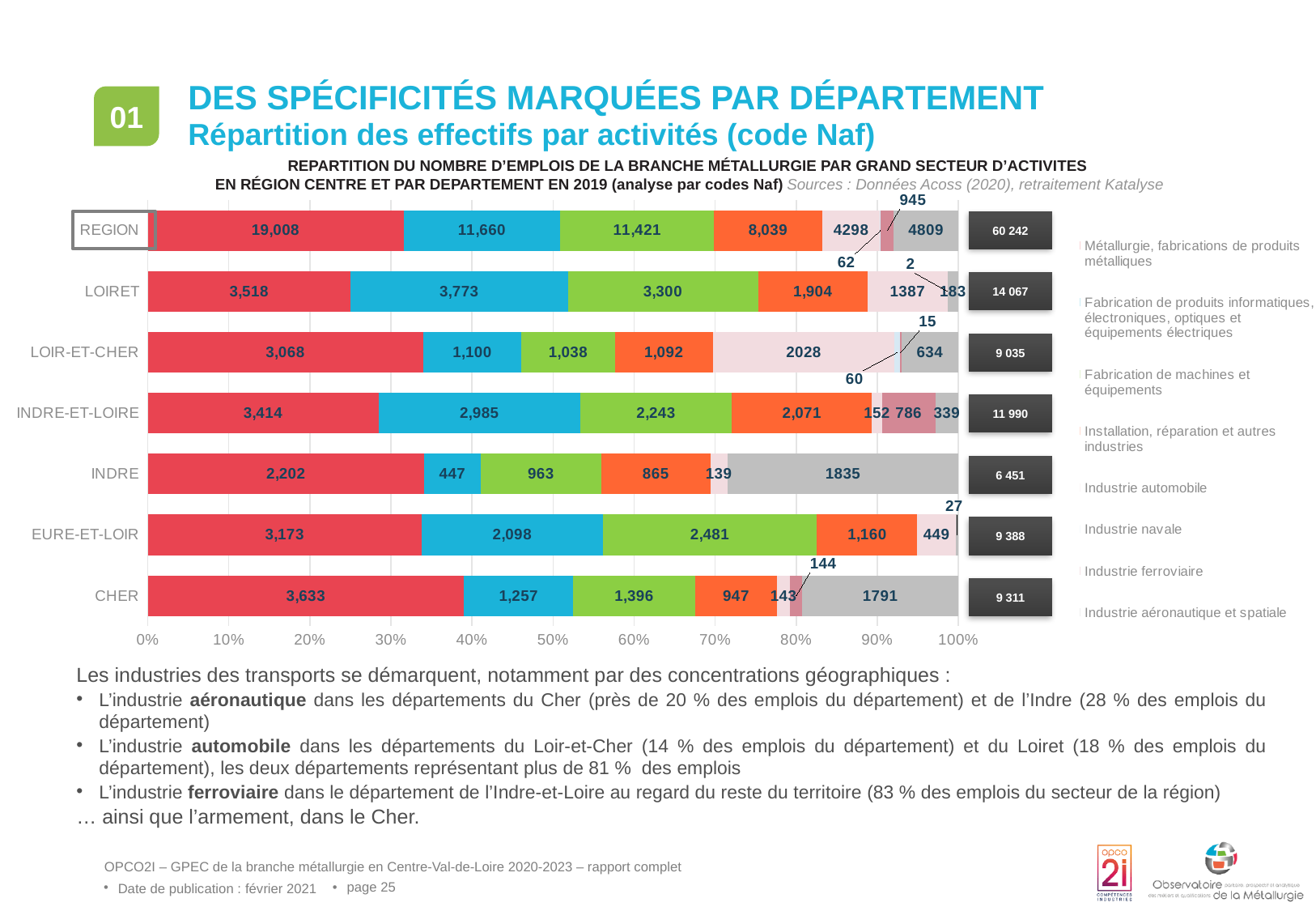
Which has the larger value for 'Fabrication de produits informatiques, électroniques, optiques et équipements électriques': LOIRET or INDRE-ET-LOIRE? LOIRET What kind of chart is shown on the slide? Stacked bar chart What is the difference between the 'Métallurgie, fabrications de produits métalliques' values for CHER and LOIRET? 115 Which department (excluding REGION) has the highest total number of jobs? LOIRET What is the value for 'Métallurgie, fabrications de produits métalliques' in CHER? 3,633 Is the share of 'Métallurgie, fabrications de produits métalliques' in CHER greater or less than 30%? greater How many activity sectors does the chart legend list? 8 Which department has the lowest total number of jobs? INDRE What is the value for 'Fabrication de produits informatiques, électroniques, optiques et équipements électriques' in LOIRET? 3,773 What total number of jobs is shown at the end of the REGION bar? 60 242 What is the value for 'Industrie aéronautique et spatiale' in INDRE? 1835 How many departments/regions are listed on the vertical axis of the chart? 7